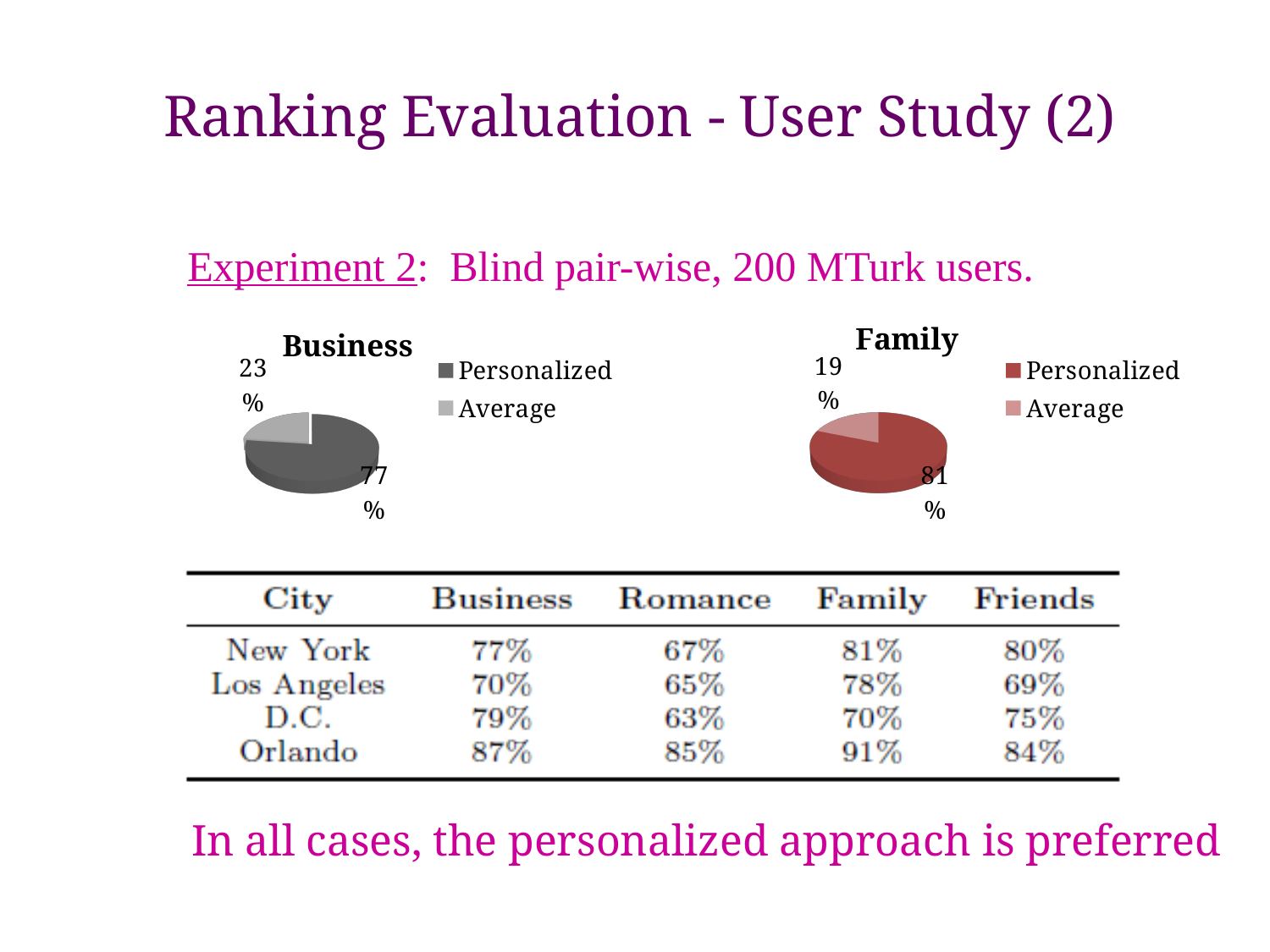
In the Family pie chart, what is the difference between the Personalized and Average shares? 62% How many entries does the legend of the Family pie chart list? 2 Is the Personalized share larger in the Business pie chart or the Family pie chart? Family In the Business pie chart, which slice is the largest? Personalized In the Family pie chart, what share does Average have? 19% In the Business pie chart, what share does Average have? 23% What kind of chart is the Business chart? Pie chart In the Business pie chart, what is the difference between the Personalized and Average shares? 54% In the Family pie chart, which slice is the smallest? Average How many slices does the Business pie chart have? 2 In the Business pie chart, what share does Personalized have? 77% In the Family pie chart, what share does Personalized have? 81%